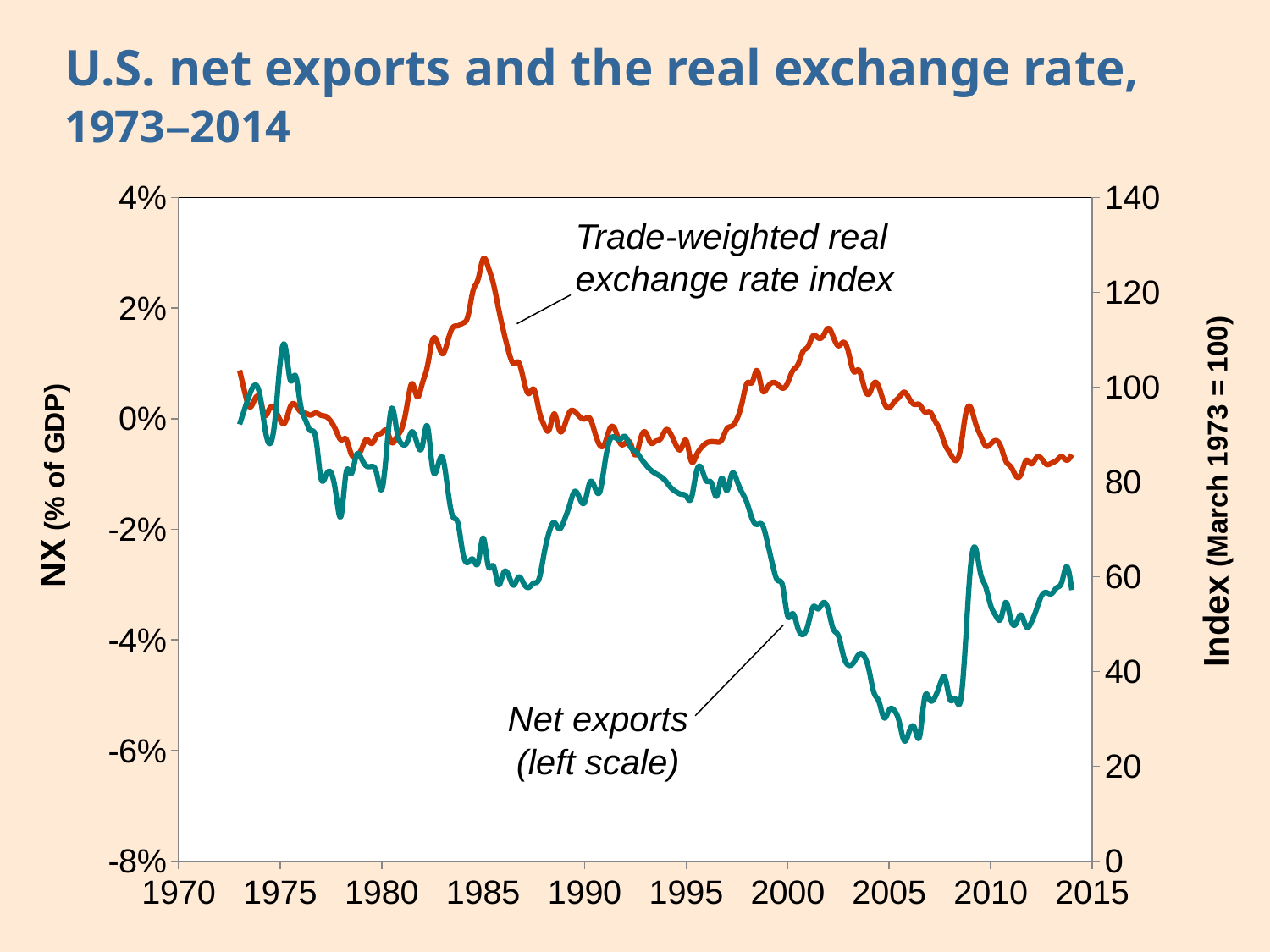
In which labeled year does the trade-weighted real exchange rate index reach its highest value? 1985 Does the trade-weighted real exchange rate index rise or fall between 1985 and 1988? fall Does net exports (% of GDP) rise or fall between 1997 and 2006? fall What kind of chart is shown on the slide? line chart Is the trade-weighted real exchange rate index at its 1985 peak greater or less than 120? greater What is the label of the right-hand vertical axis? Index (March 1973 = 100) Is the trade-weighted real exchange rate index in 2014 greater or less than 100? less What is the title of the chart? U.S. net exports and the real exchange rate, 1973–2014 How many data series are plotted on the chart? 2 Does the trade-weighted real exchange rate index rise or fall between 1995 and 2002? rise Is the value of net exports (% of GDP) around 2006 greater or less than -4%? less